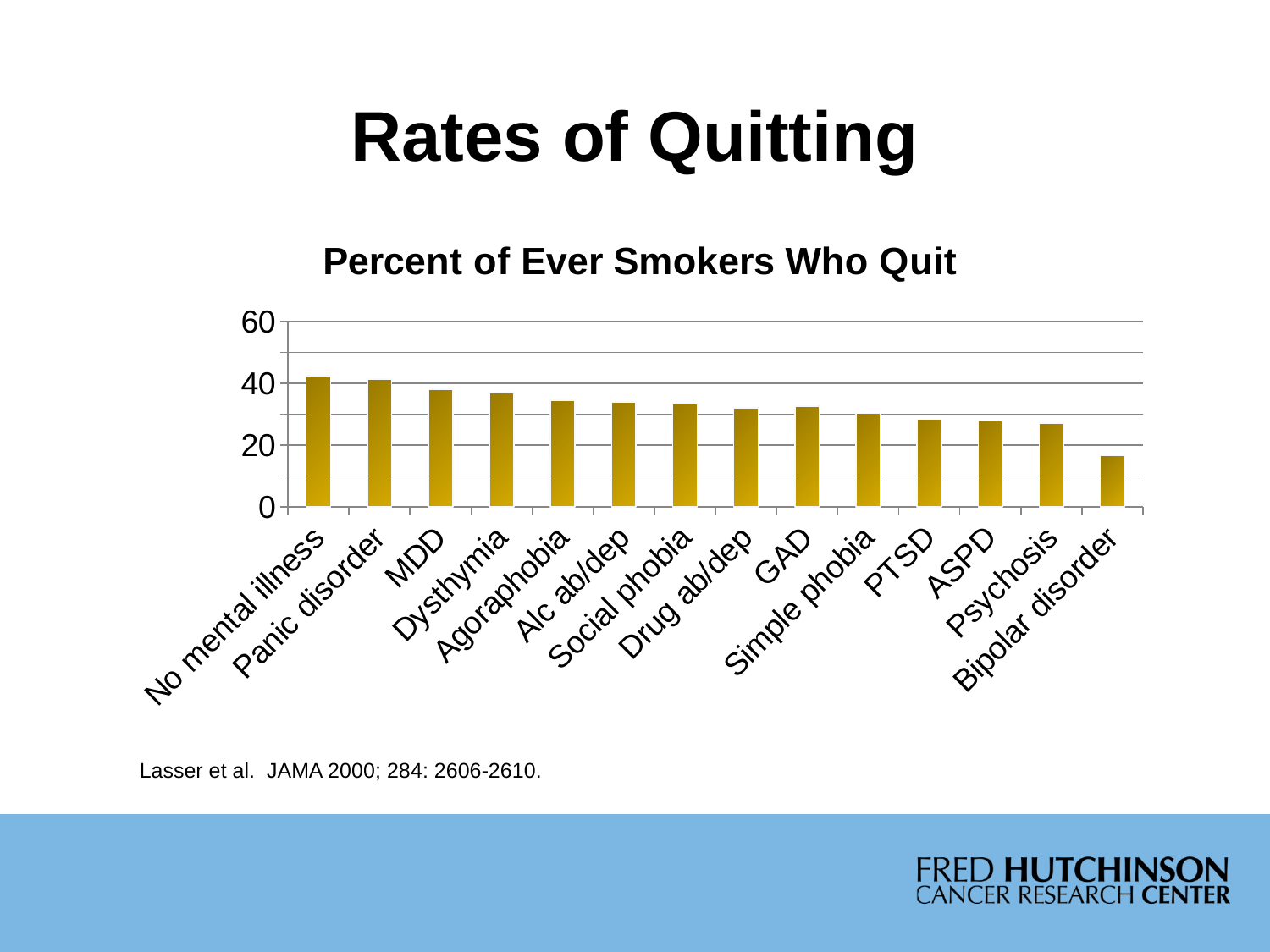
What is the title of the chart? Percent of Ever Smokers Who Quit Which is larger, the value for MDD or the value for Bipolar disorder? MDD Is the value for No mental illness greater or less than 40? greater Is the value for PTSD greater or less than 20? greater Is the value for Bipolar disorder greater or less than 20? less Which category has the lowest percent of ever smokers who quit? Bipolar disorder Which is larger, the value for PTSD or the value for No mental illness? No mental illness Do the values generally rise or fall moving from left to right along the x axis? Fall What kind of chart is shown on the slide? Bar chart How many categories are plotted on the chart? 14